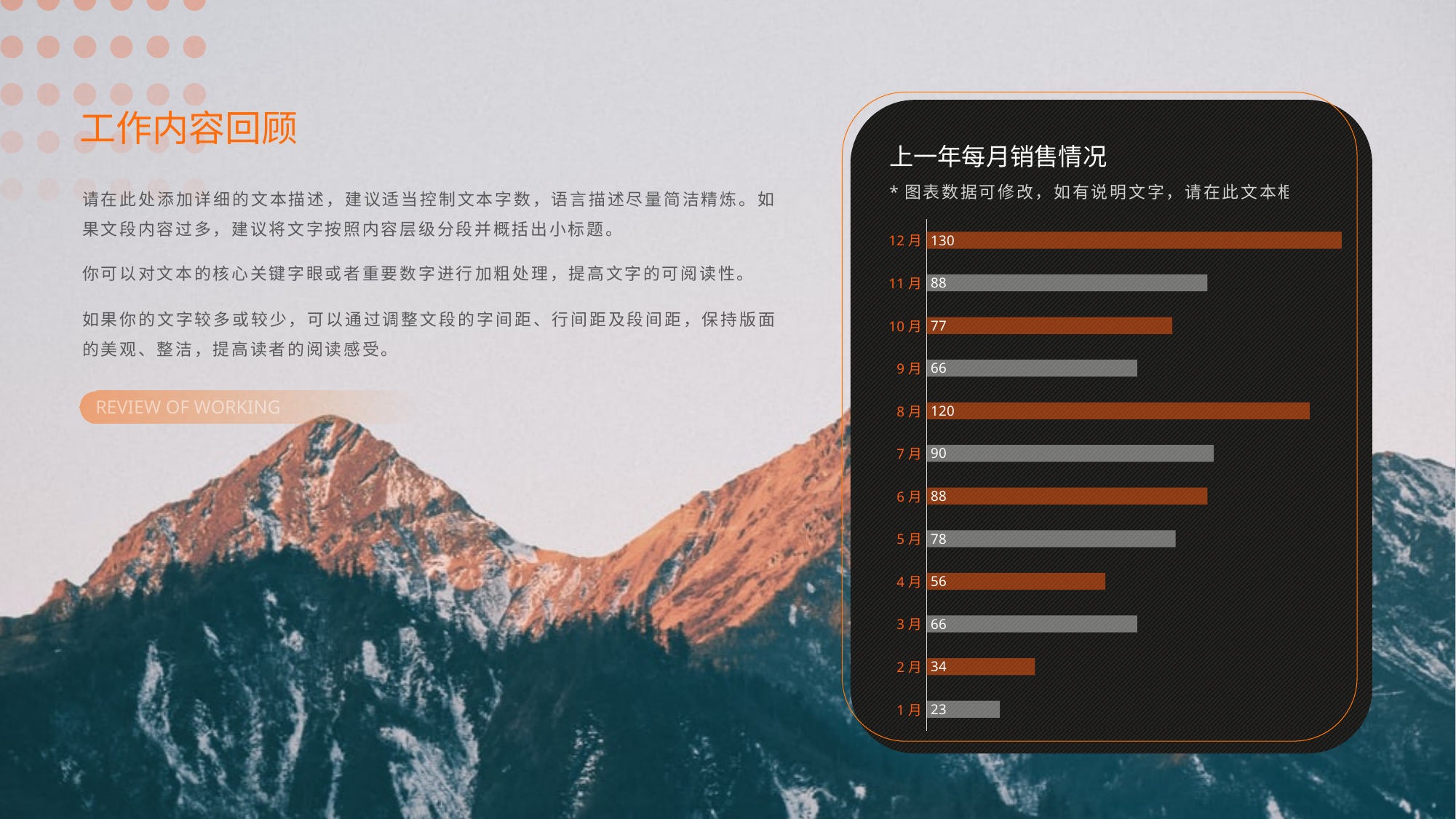
What is the value for 5月? 78 What kind of chart is shown on the slide? bar chart Which month has the highest value? 12月 What is the value for 1月? 23 What is the value for 8月? 120 What is the difference between the values for 12月 and 8月? 10 Which month has the lowest value? 1月 What is the difference between the values for 2月 and 1月? 11 Which is larger, the value for 7月 or the value for 10月? 7月 What is the value for 12月? 130 How many months are shown in the chart? 12 What is the title of the chart? 上一年每月销售情况